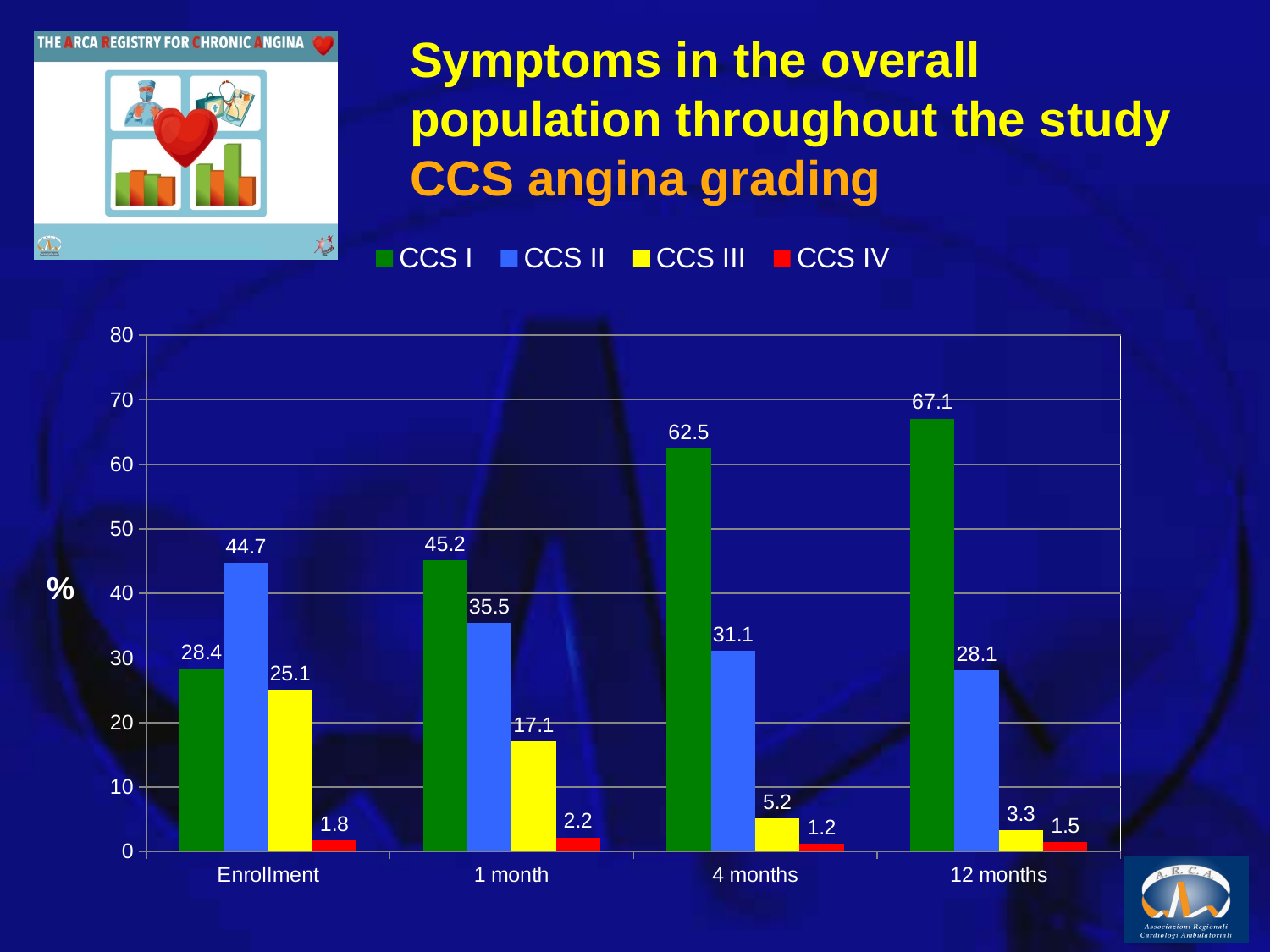
What is the value for CCS I at Enrollment? 28.4 At which time point is the CCS I value highest? 12 months What is the value for CCS II at 1 month? 35.5 What is the value for CCS III at 4 months? 5.2 What is the value for CCS IV at 12 months? 1.5 Does the CCS II value rise or fall from Enrollment to 12 months? fall How many time points are shown on the x axis? 4 What is the difference between the CCS I value at 12 months and at Enrollment? 38.7 Which is larger at Enrollment, CCS I or CCS II? CCS II What kind of chart is shown on the slide? bar chart How many series does the legend list? 4 At which time point is the CCS III value lowest? 12 months